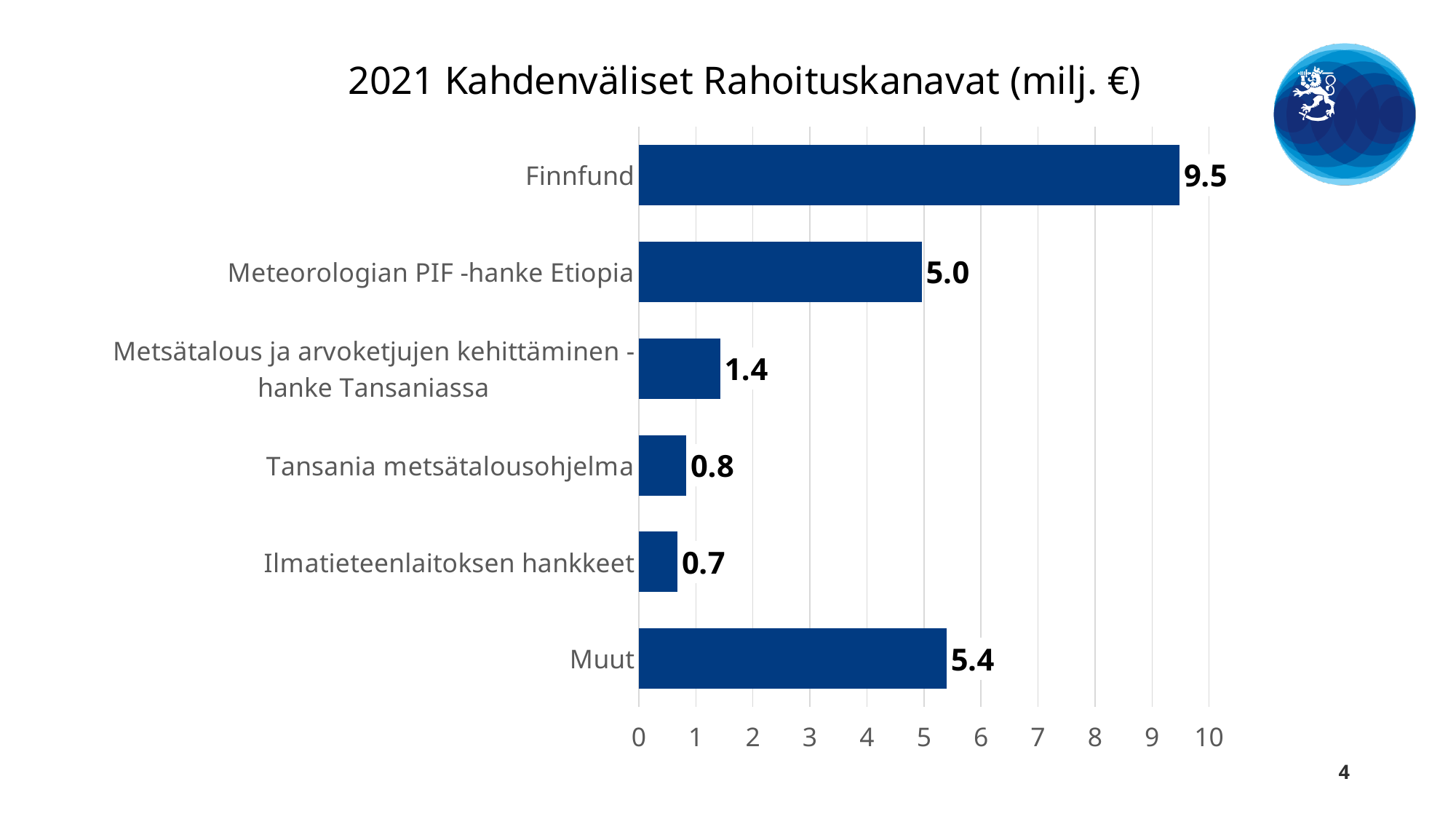
What is the value for Ilmatieteenlaitoksen hankkeet? 0.7 What is the value for Finnfund? 9.5 What is the difference between the values for Finnfund and Muut? 4.1 Which category has the lowest value? Ilmatieteenlaitoksen hankkeet Which category has the highest value? Finnfund What is the value for Meteorologian PIF -hanke Etiopia? 5.0 What is the value for Muut? 5.4 What is the difference between the values for Tansania metsätalousohjelma and Ilmatieteenlaitoksen hankkeet? 0.1 What is the title of the chart? 2021 Kahdenväliset Rahoituskanavat (milj. €) How many categories are shown in the chart? 6 What kind of chart is shown on the slide? Bar chart Which is larger, the value for Muut or the value for Meteorologian PIF -hanke Etiopia? Muut